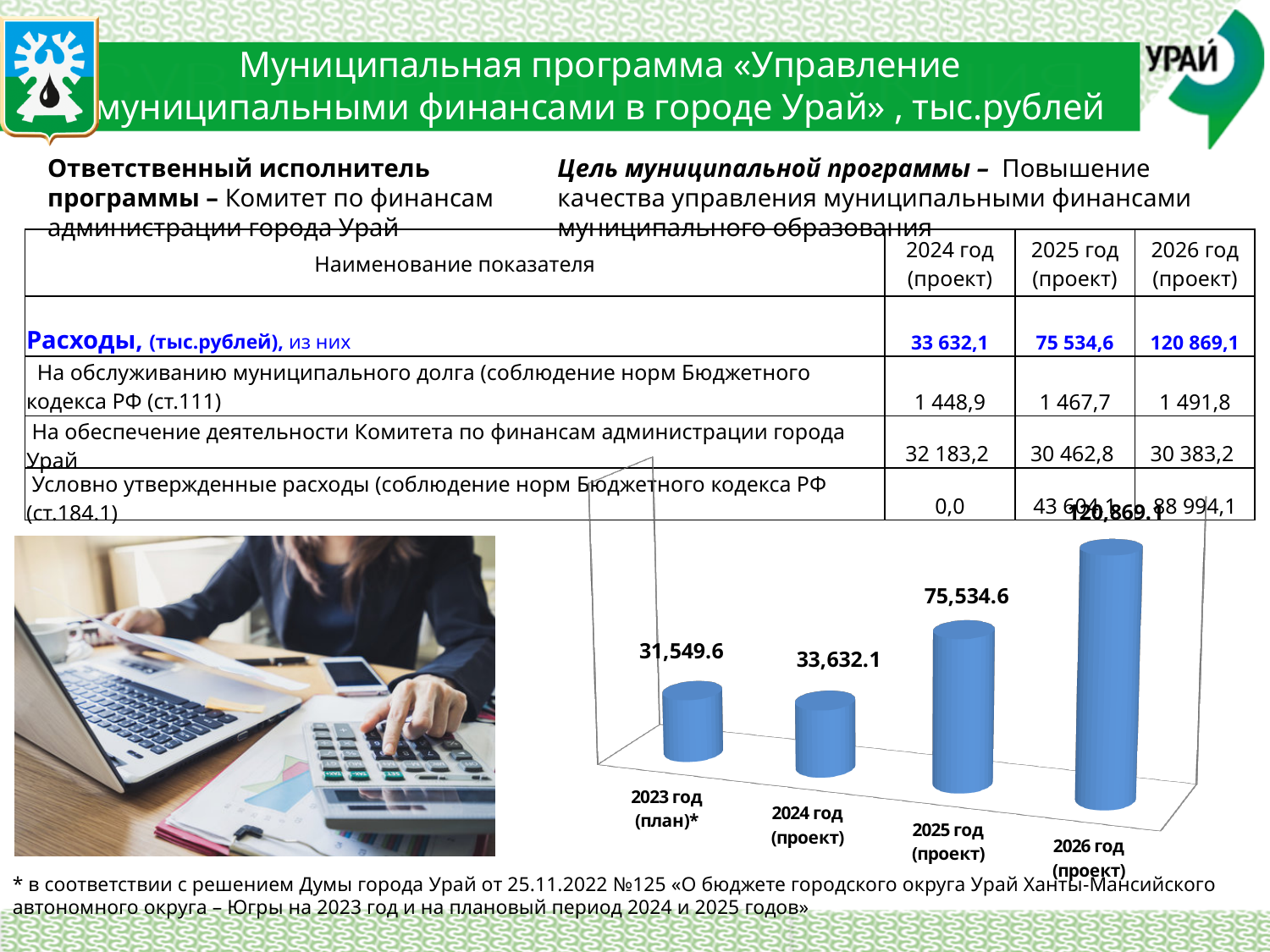
What is the value shown for 2024 год (проект) in the chart? 33,632.1 How many categories (years) are plotted in the chart? 4 Which year has the highest value in the chart? 2026 год (проект) What is the value shown for 2025 год (проект) in the chart? 75,534.6 What type of chart is shown on the slide? bar chart What is the value shown for 2023 год (план)* in the chart? 31,549.6 Do the values in the chart rise or fall from 2023 to 2026? rise What is the difference between the values for 2024 год (проект) and 2023 год (план)*? 2,082.5 Which year has the lowest value in the chart? 2023 год (план)* What is the difference between the values for 2025 год (проект) and 2024 год (проект)? 41,902.5 What is the value shown for 2026 год (проект) in the chart? 120,869.1 Which is larger: the value for 2025 год (проект) or the value for 2024 год (проект)? 2025 год (проект)